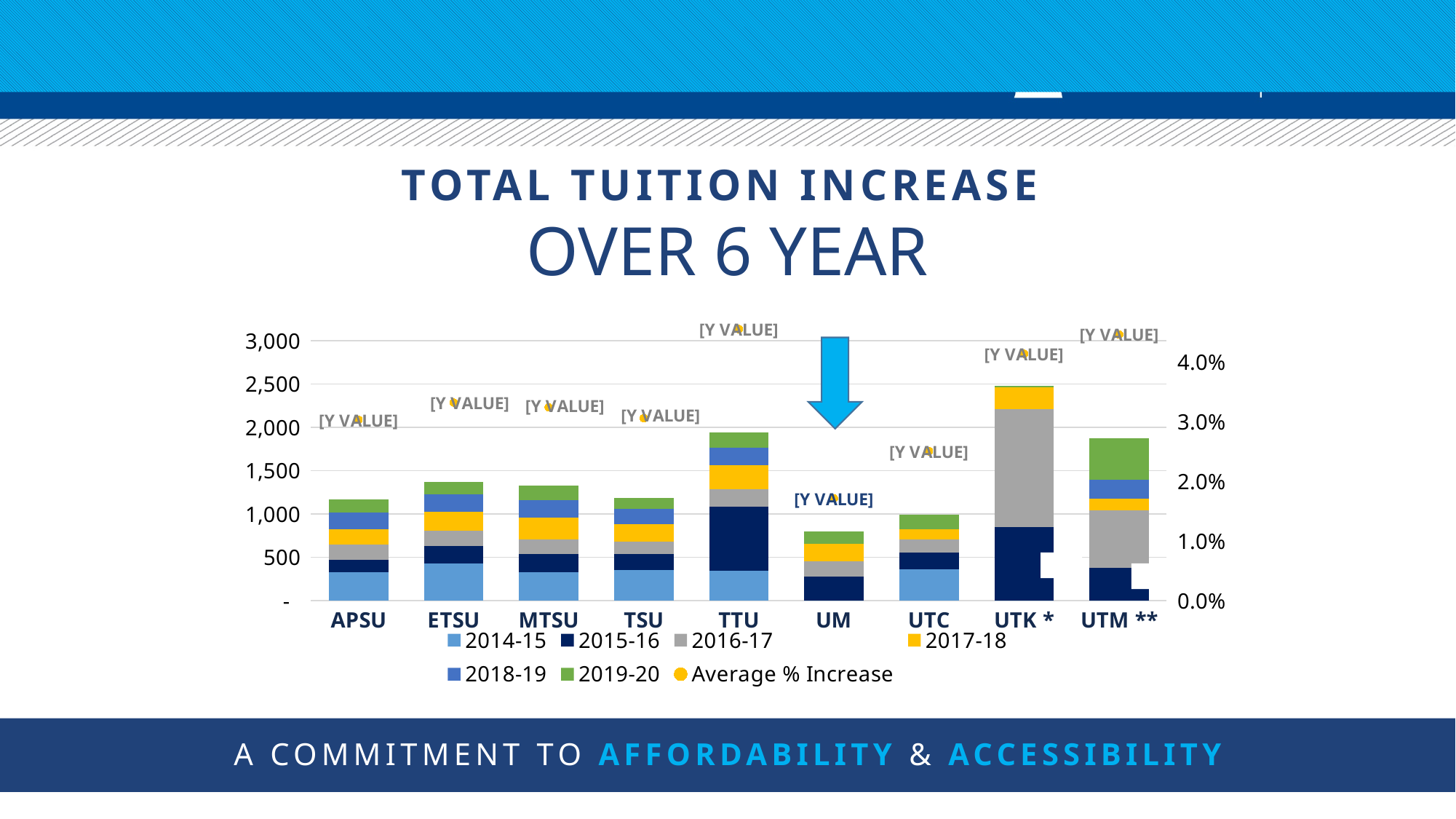
What kind of chart is shown on the slide? Stacked bar chart with a line/marker series Which has the taller stacked bar, ETSU or APSU? ETSU What is the title of the chart on the slide? TOTAL TUITION INCREASE OVER 6 YEAR Which institution has the shortest stacked bar? UM Which has the taller stacked bar, UTC or UM? UTC How many institutions (categories) are shown on the x axis? 9 Is the total stacked bar for UM greater or less than 1,000? less How many series does the legend list? 7 Is the total stacked bar for TTU greater or less than 1,500? greater Which institution has the lowest Average % Increase marker? UM Is the total stacked bar for UTK * greater or less than 2,000? greater Which institution has the tallest stacked bar? UTK *